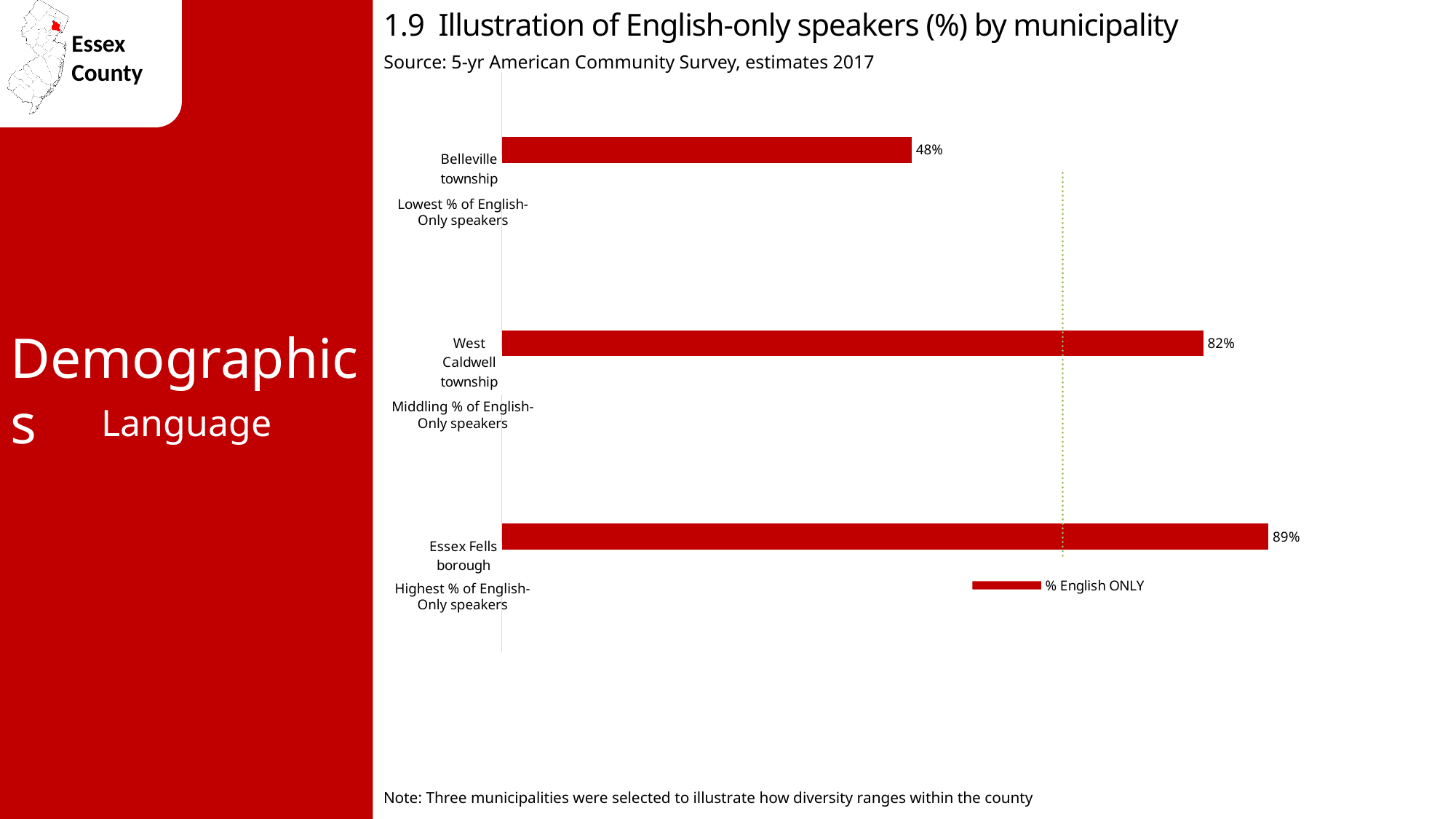
What is the percentage of English-only speakers in West Caldwell township? 82% Which municipality has the lowest percentage of English-only speakers? Belleville township What is the legend entry for the series shown in the chart? % English ONLY What is the difference in percentage points between West Caldwell township and Belleville township? 34 What is the percentage of English-only speakers in Essex Fells borough? 89% What kind of chart is shown on the slide? Bar chart What is the difference in percentage points between Essex Fells borough and Belleville township? 41 Which municipality has the highest percentage of English-only speakers? Essex Fells borough How many series does the legend list? 1 How many municipalities are shown in the chart? 3 Which has a higher percentage of English-only speakers, West Caldwell township or Belleville township? West Caldwell township What is the percentage of English-only speakers in Belleville township? 48%